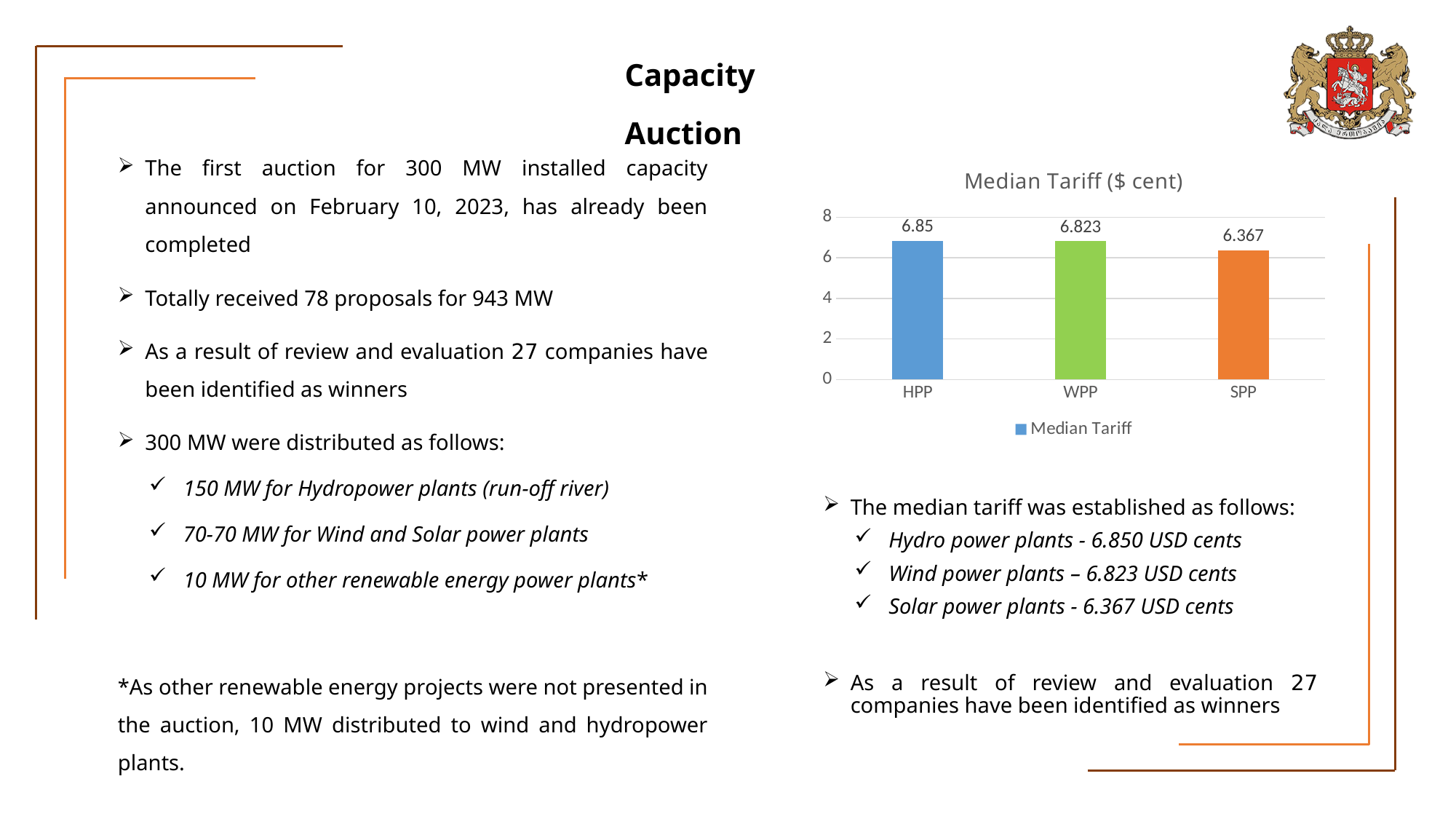
What is the median tariff for SPP in the Median Tariff ($ cent) chart? 6.367 Which category has the highest median tariff according to the data labels in the chart? HPP Is the median tariff for SPP greater or less than 6? greater Which category has the lowest median tariff in the chart? SPP What is the median tariff for WPP in the Median Tariff ($ cent) chart? 6.823 What is the difference between the median tariff for HPP and SPP? 0.483 What kind of chart is used to show the median tariff? bar chart What is the difference between the median tariff for WPP and SPP? 0.456 Do the median tariff values rise or fall from HPP to SPP along the x axis? fall Which has a larger median tariff, HPP or SPP? HPP How many categories are shown in the Median Tariff chart? 3 What is the median tariff for HPP in the Median Tariff ($ cent) chart? 6.85